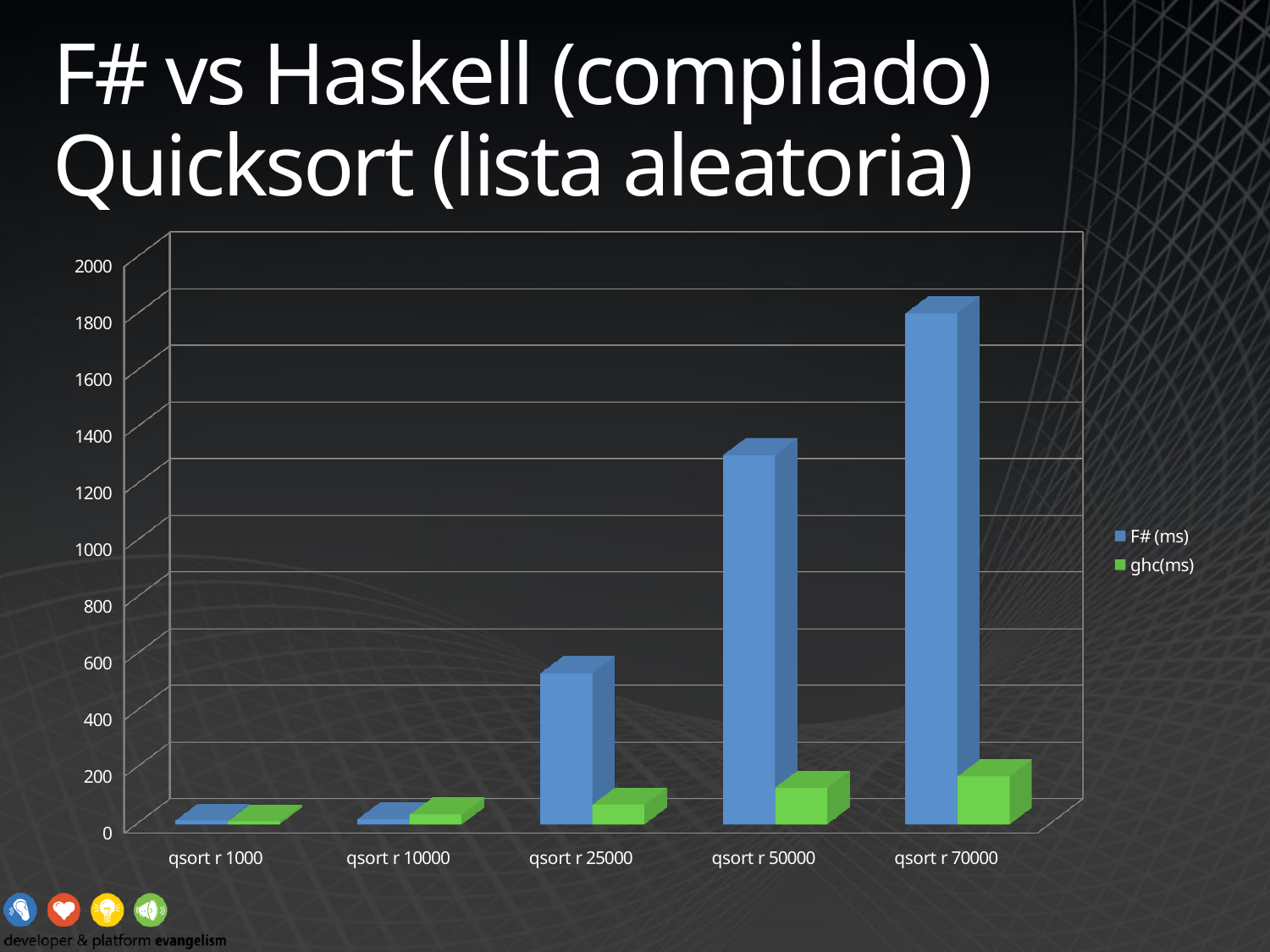
What colour are the ghc(ms) bars? green How many series does the legend list? 2 Which category has the highest F# (ms) value? qsort r 70000 Is the F# (ms) value for qsort r 70000 greater or less than 1600? greater Do the F# (ms) values rise or fall as the list size increases along the x axis? rise Is the F# (ms) value for qsort r 25000 greater or less than 400? greater Is the F# (ms) value for qsort r 50000 greater or less than 1200? greater What kind of chart is shown on the slide? bar chart Which category has the highest ghc(ms) value? qsort r 70000 For qsort r 50000, which series has the larger value, F# (ms) or ghc(ms)? F# (ms) How many categories are shown on the x axis? 5